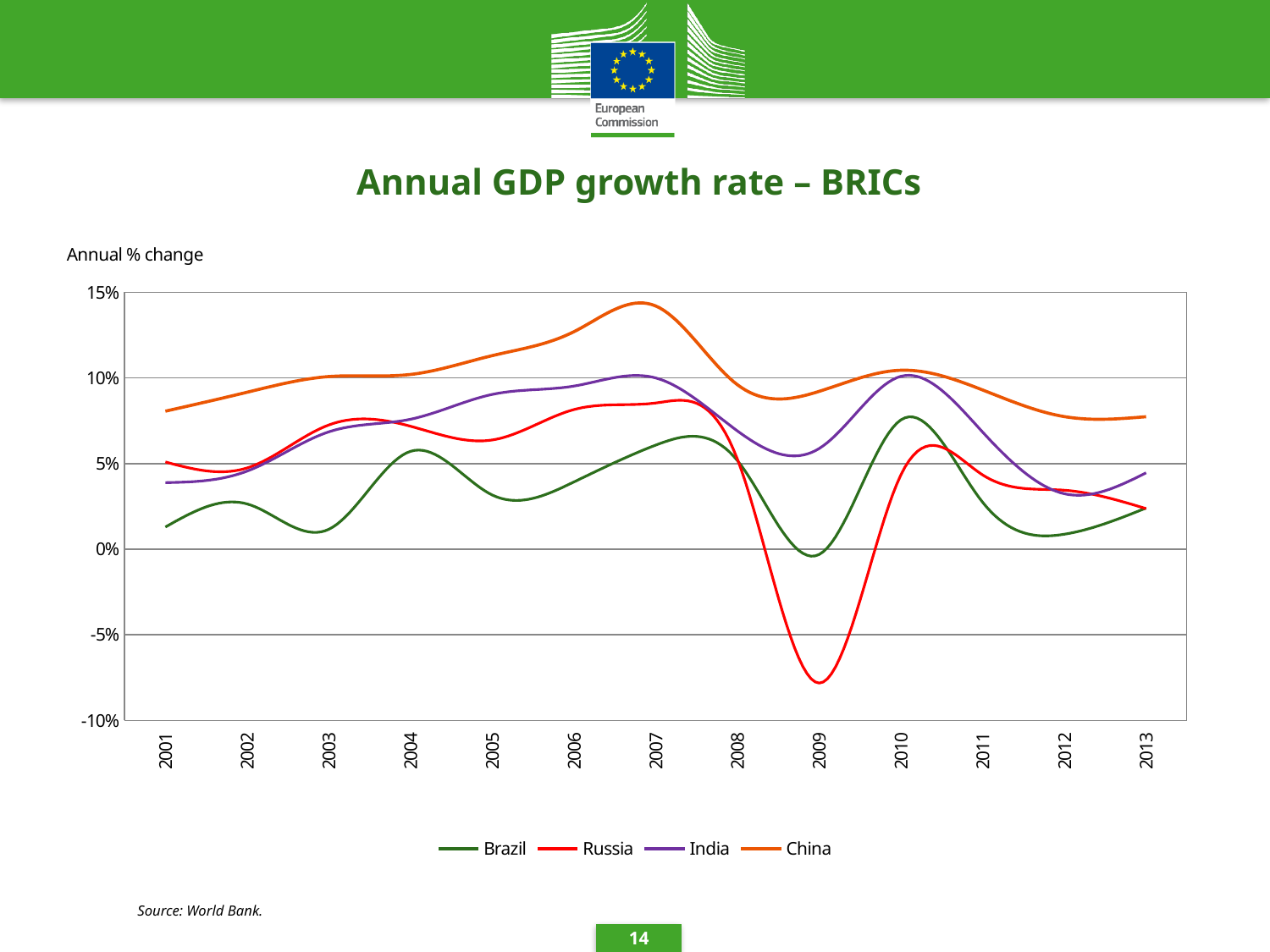
What kind of chart is shown on the slide? line chart Which country has the lowest GDP growth rate in 2009? Russia Which country has the lowest GDP growth rate in 2001? Brazil What is the title of the chart? Annual GDP growth rate – BRICs Does the value for China rise or fall from 2010 to 2013? fall How many years are shown on the x axis? 13 In 2001, which is larger, the value for China or the value for Brazil? China How many series does the legend list? 4 Is the value for China in 2007 greater or less than 10%? greater Is the value for Russia in 2009 greater or less than -5%? less Is the value for Brazil in 2003 greater or less than 5%? less Which country has the highest GDP growth rate in 2007? China